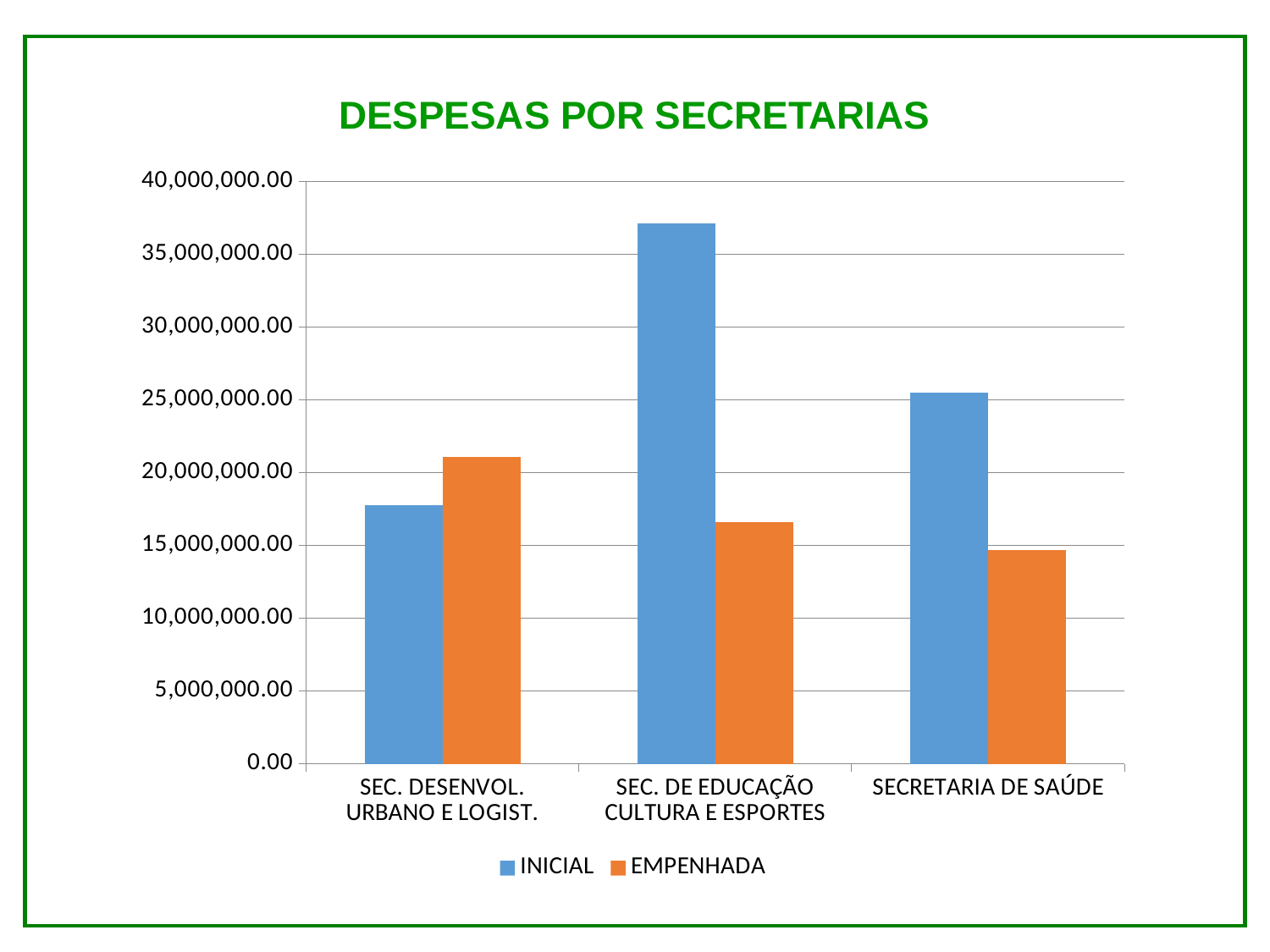
Which category has the highest INICIAL value? SEC. DE EDUCAÇÃO CULTURA E ESPORTES How many categories are shown on the x axis? 3 What is the title of the chart? DESPESAS POR SECRETARIAS How many series does the legend list? 2 For SEC. DESENVOL. URBANO E LOGIST., which is larger, INICIAL or EMPENHADA? EMPENHADA For SECRETARIA DE SAÚDE, which is larger, INICIAL or EMPENHADA? INICIAL Which category has the lowest INICIAL value? SEC. DESENVOL. URBANO E LOGIST. Which category has the lowest EMPENHADA value? SECRETARIA DE SAÚDE Which colour represents the EMPENHADA series in the legend? orange Is the EMPENHADA value for SECRETARIA DE SAÚDE greater or less than 15,000,000.00? less Is the INICIAL value for SEC. DE EDUCAÇÃO CULTURA E ESPORTES greater or less than 35,000,000.00? greater What kind of chart is shown on the slide? bar chart